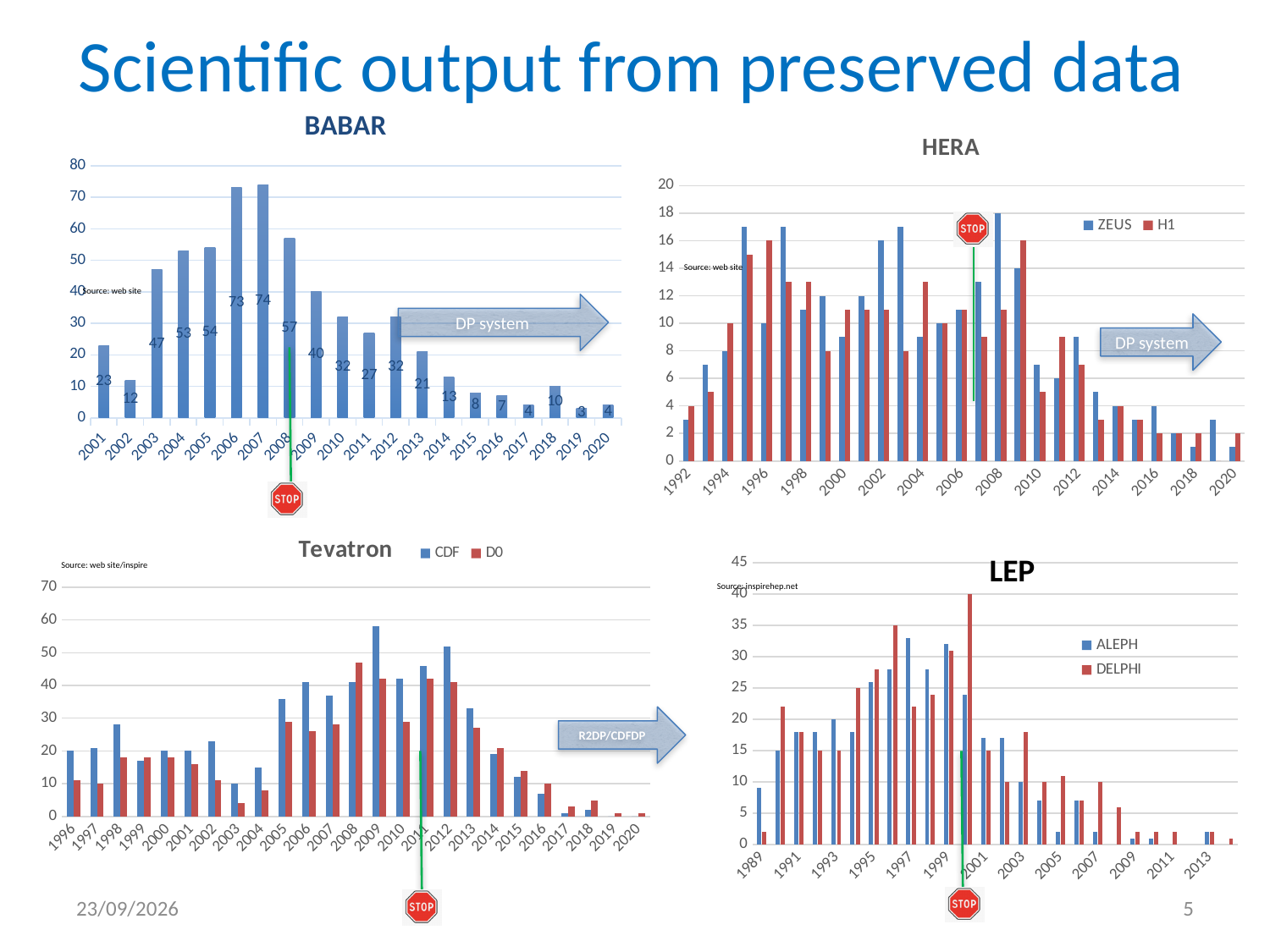
On the HERA chart, how many series does the legend list? 2 On the Tevatron chart, is the CDF value for 2009 greater or less than 50? greater On the BABAR chart, what is the value for 2013? 21 On the LEP chart, which series is larger in 2000, ALEPH or DELPHI? DELPHI On the HERA chart, is the ZEUS value for 2008 greater or less than 16? greater On the BABAR chart, how many years are shown on the x axis? 20 On the BABAR chart, which year has the lowest value? 2019 On the BABAR chart, what is the value for 2007? 74 What kind of chart is the LEP chart? bar chart On the BABAR chart, what is the difference between the values for 2008 and 2009? 17 On the BABAR chart, which year has the highest value? 2007 On the Tevatron chart, which series is larger in 2009, CDF or D0? CDF